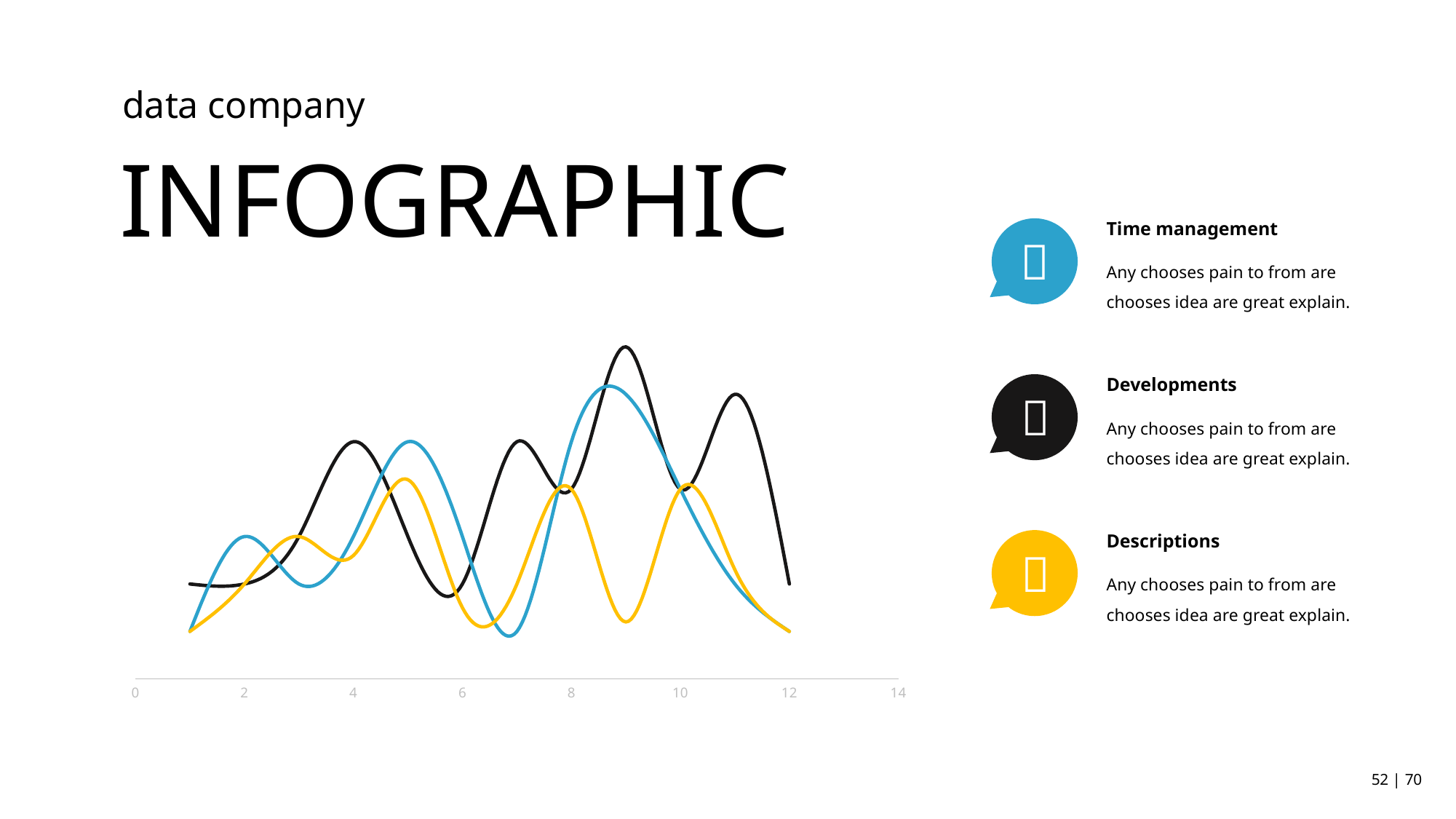
What colours are the three lines on the chart? black, blue and yellow Around x = 2, is the blue line or the black line higher? blue How many tick labels are shown on the x axis of the chart? 8 Does the black line rise or fall between x = 11 and x = 12? fall Which line reaches the highest peak on the chart? black Around x = 5, is the blue line or the yellow line higher? blue Around x = 9, is the black line or the yellow line higher? black What is the highest value labelled on the x axis of the chart? 14 What kind of chart is shown on the slide? line chart How many lines are plotted on the chart? 3